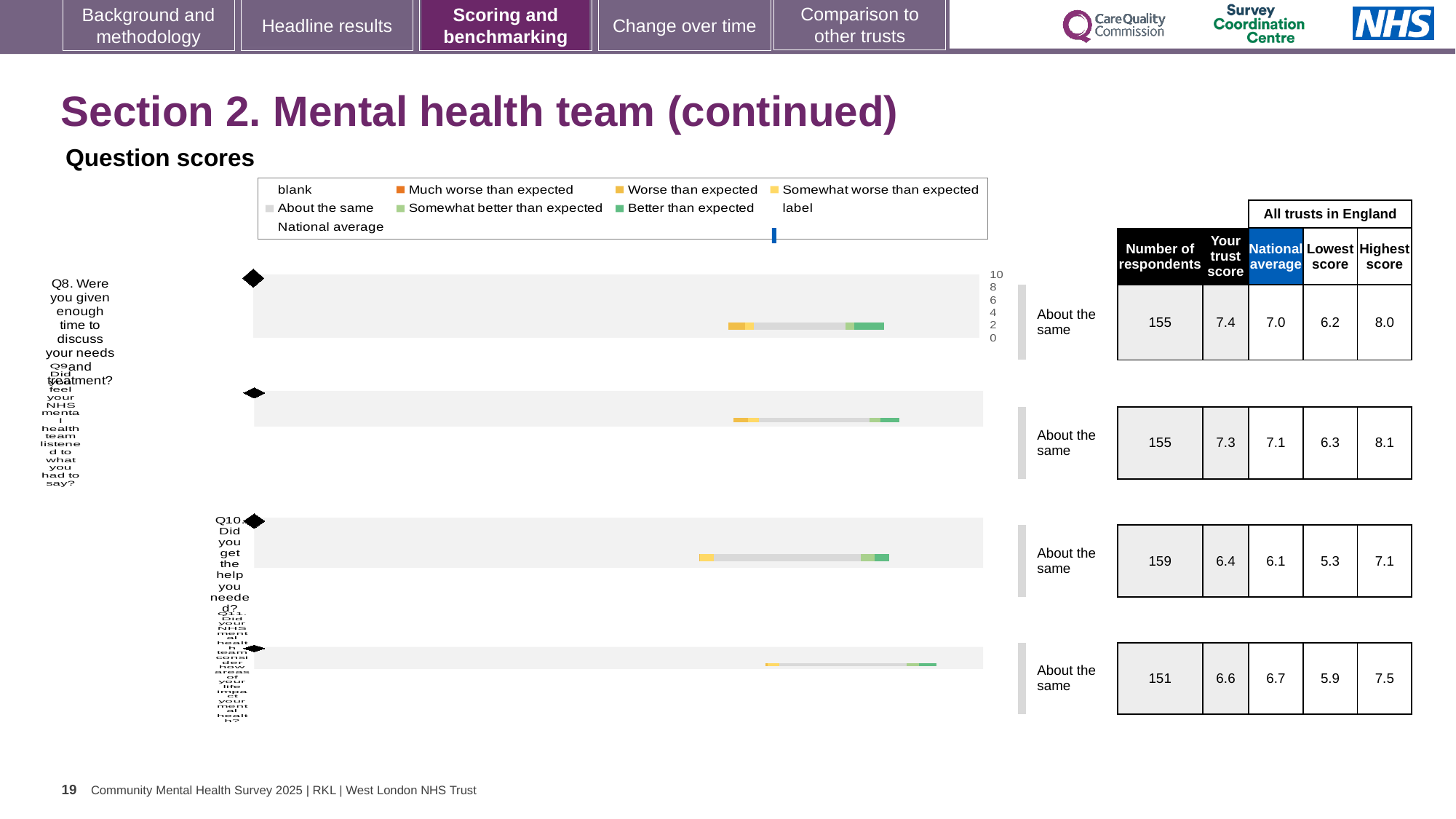
What is the lowest score across all trusts in England for Q10 (Did you get the help you needed?)? 5.3 What is the highest score across all trusts in England for Q11? 7.5 For Q8, what is the difference between the trust score and the national average? 0.4 What is the national average score for Q9 (Did you feel your NHS mental health team listened to what you had to say?)? 7.1 How many questions are charted on this slide? 4 For Q11, which is larger: the trust score or the national average? National average Which question has the highest trust score on this slide? Q8 What benchmark category is shown for Q10? About the same What kind of chart is used to show the question scores? Bar chart What is the trust score for Q8 (Were you given enough time to discuss your needs and treatment?)? 7.4 How many respondents answered Q8? 155 Which question has the lowest trust score on this slide? Q10